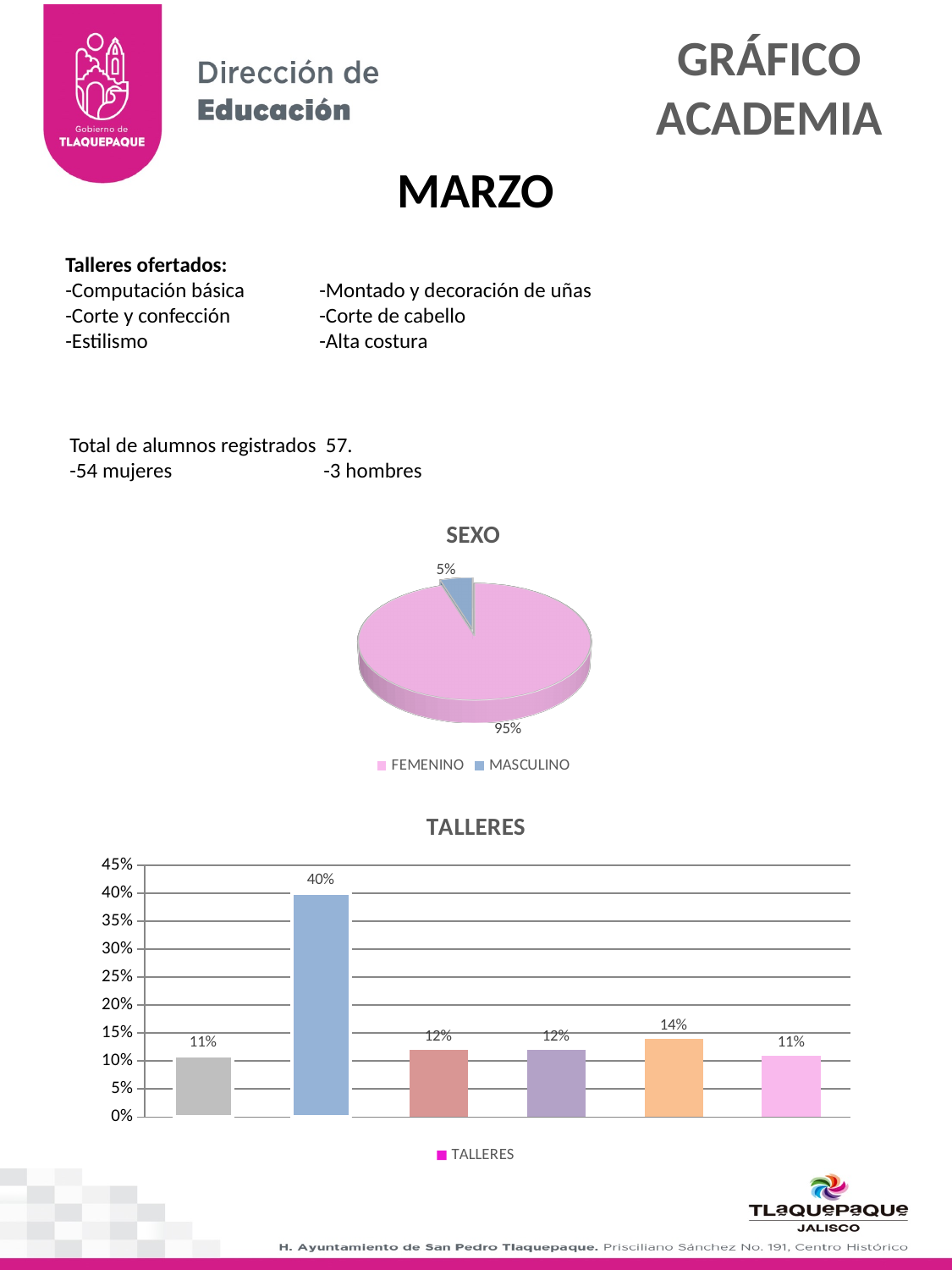
In the TALLERES chart, what is the highest value shown on any bar? 40% In the SEXO pie chart, what is the difference between the FEMENINO and MASCULINO shares? 90% In the SEXO pie chart, what share is labelled for FEMENINO? 95% In the TALLERES chart, what is the value labelled on the fifth bar from the left? 14% In the TALLERES chart, what is the difference between the tallest bar (40%) and the fifth bar (14%)? 26% How many entries does the legend of the SEXO chart list? 2 In the SEXO pie chart, what share is labelled for MASCULINO? 5% In the TALLERES chart, what is the value labelled on the second bar from the left? 40% What kind of chart is the SEXO chart? Pie chart How many bars are plotted in the TALLERES chart? 6 What kind of chart is the TALLERES chart? Bar chart In the SEXO pie chart, which slice is larger, FEMENINO or MASCULINO? FEMENINO